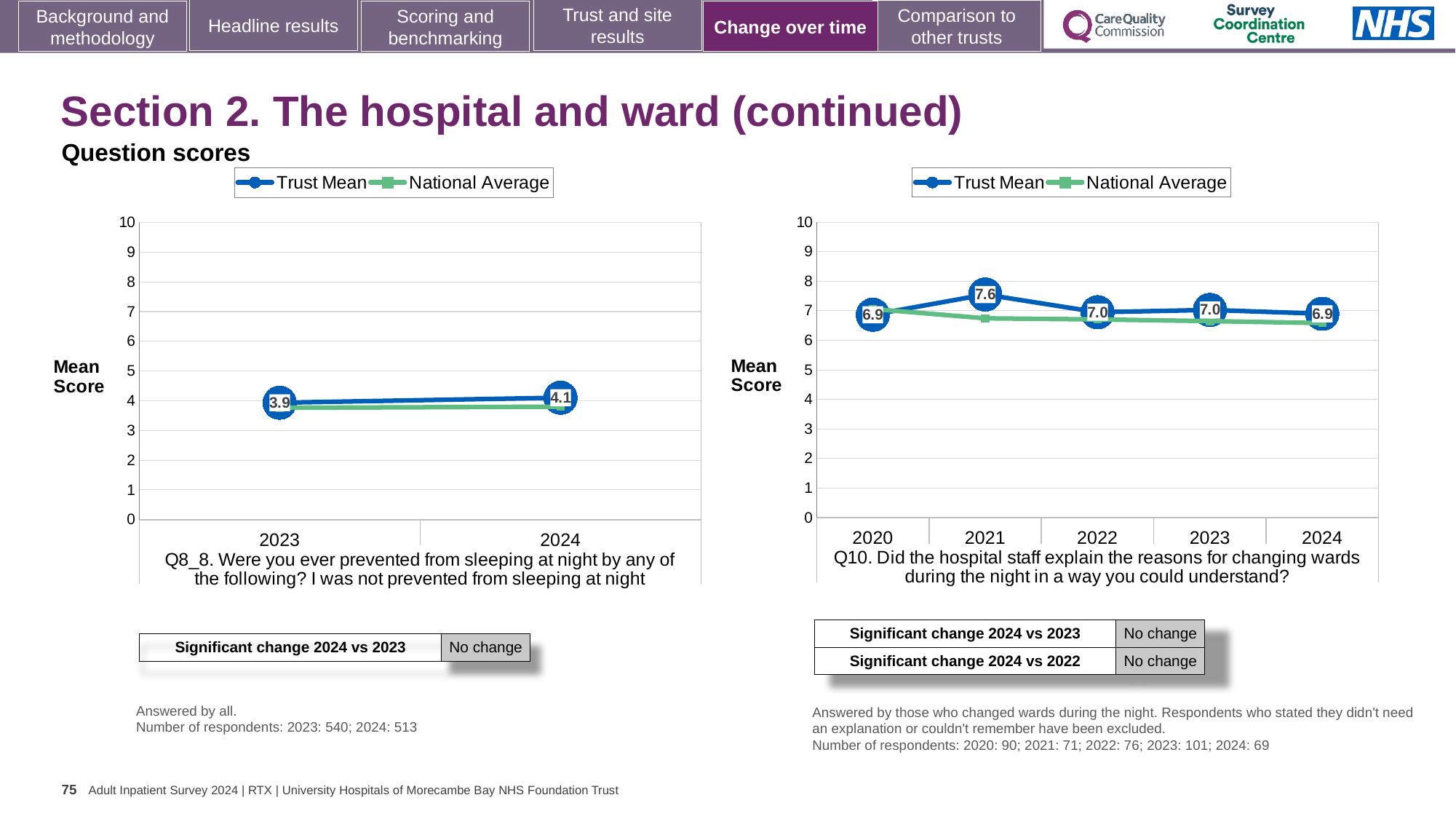
How many series does the legend of the Q8_8 chart on the left list? 2 In the Q8_8 chart on the left, what is the Trust Mean score for 2023? 3.9 In the Q10 chart on the right, how many years are shown on the x axis? 5 In the Q8_8 chart on the left, is the Trust Mean for 2024 greater or less than 5? less In the Q10 chart on the right, what is the Trust Mean score for 2021? 7.6 In the Q8_8 chart on the left, by how much did the Trust Mean change from 2023 to 2024? 0.2 In the Q10 chart on the right, which year has the highest Trust Mean score? 2021 In the Q10 chart on the right, what is the Trust Mean score for 2024? 6.9 What type of chart is the Q10 chart on the right? Line chart In the Q10 chart on the right, is the National Average for 2021 greater or less than 7? less In the Q10 chart on the right, what is the difference between the Trust Mean in 2021 and in 2022? 0.6 In the Q8_8 chart on the left, what is the Trust Mean score for 2024? 4.1